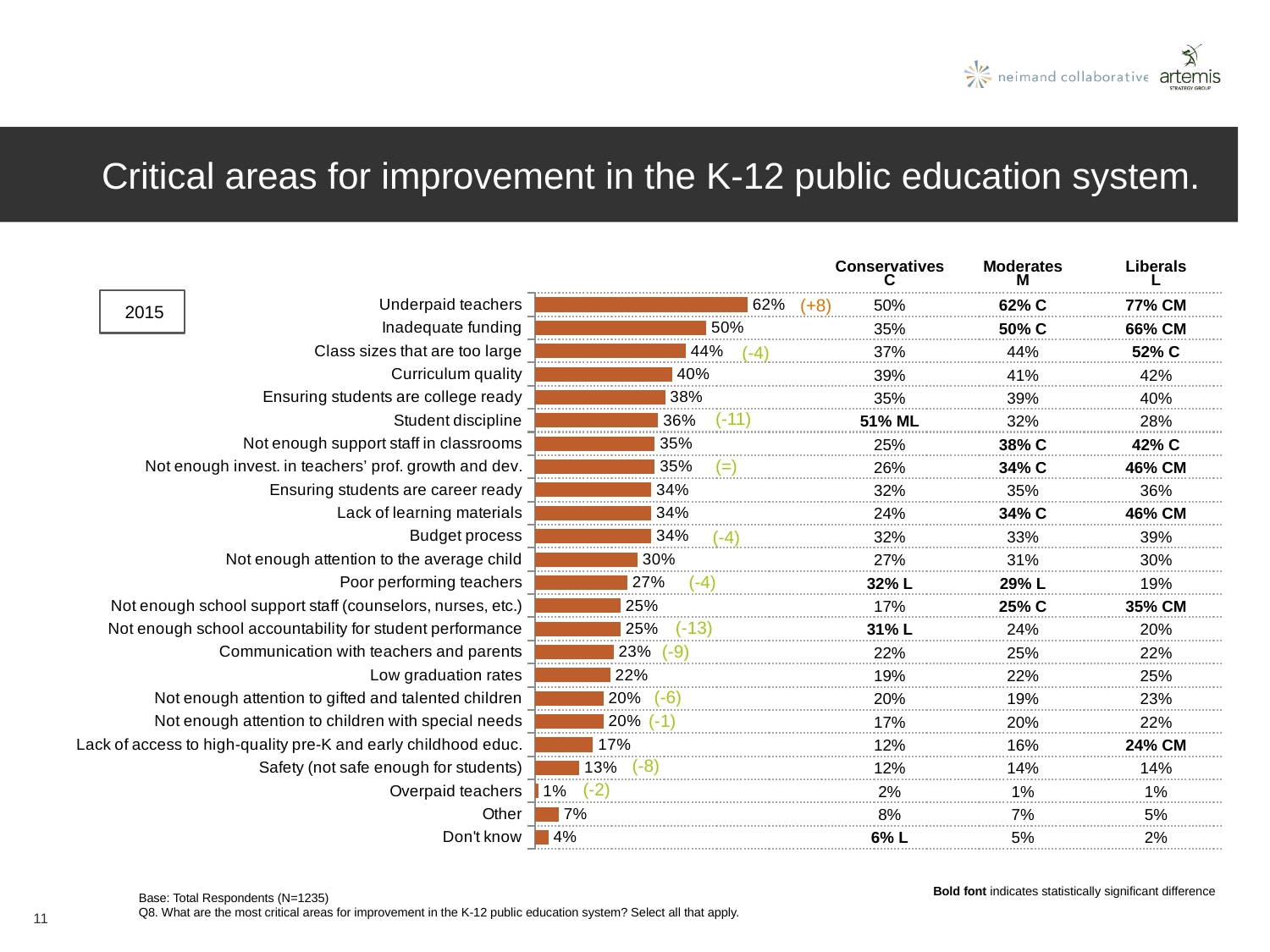
Which category has the highest value in the bar chart? Underpaid teachers How many categories are plotted in the bar chart? 24 What is the value for Inadequate funding in the bar chart? 50% What year label is shown next to the bar chart? 2015 What type of chart is shown on the slide? bar chart What is the difference between the values for Underpaid teachers and Inadequate funding? 12% What is the value for Student discipline in the bar chart? 36% What is the difference between the values for Class sizes that are too large and Curriculum quality? 4% What is the value for Safety (not safe enough for students) in the bar chart? 13% What is the value for Underpaid teachers in the bar chart? 62% Which is larger in the bar chart: Low graduation rates or Lack of access to high-quality pre-K and early childhood educ.? Low graduation rates Which category has the lowest value in the bar chart? Overpaid teachers